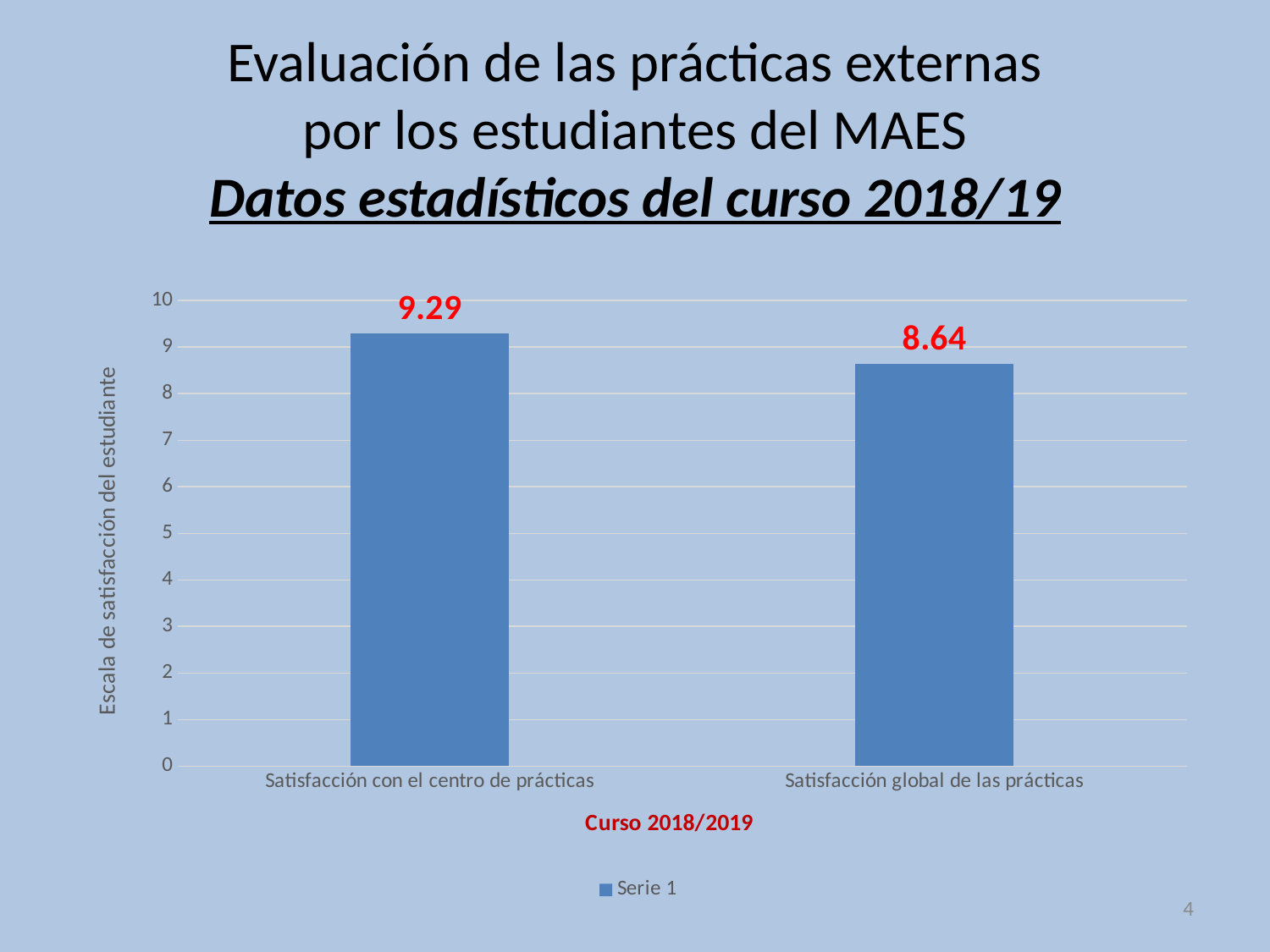
Which category has the lowest value? Satisfacción global de las prácticas What is the value for "Satisfacción con el centro de prácticas"? 9.29 Is the value for "Satisfacción con el centro de prácticas" greater or less than 9? greater Which is larger: the value for "Satisfacción con el centro de prácticas" or for "Satisfacción global de las prácticas"? Satisfacción con el centro de prácticas How many series does the legend list? 1 What is the label of the vertical axis? Escala de satisfacción del estudiante How many categories are shown on the chart? 2 What is the value for "Satisfacción global de las prácticas"? 8.64 What kind of chart is shown on the slide? bar chart Which category has the highest value? Satisfacción con el centro de prácticas Is the value for "Satisfacción global de las prácticas" greater or less than 9? less What is the difference between the values for "Satisfacción con el centro de prácticas" and "Satisfacción global de las prácticas"? 0.65